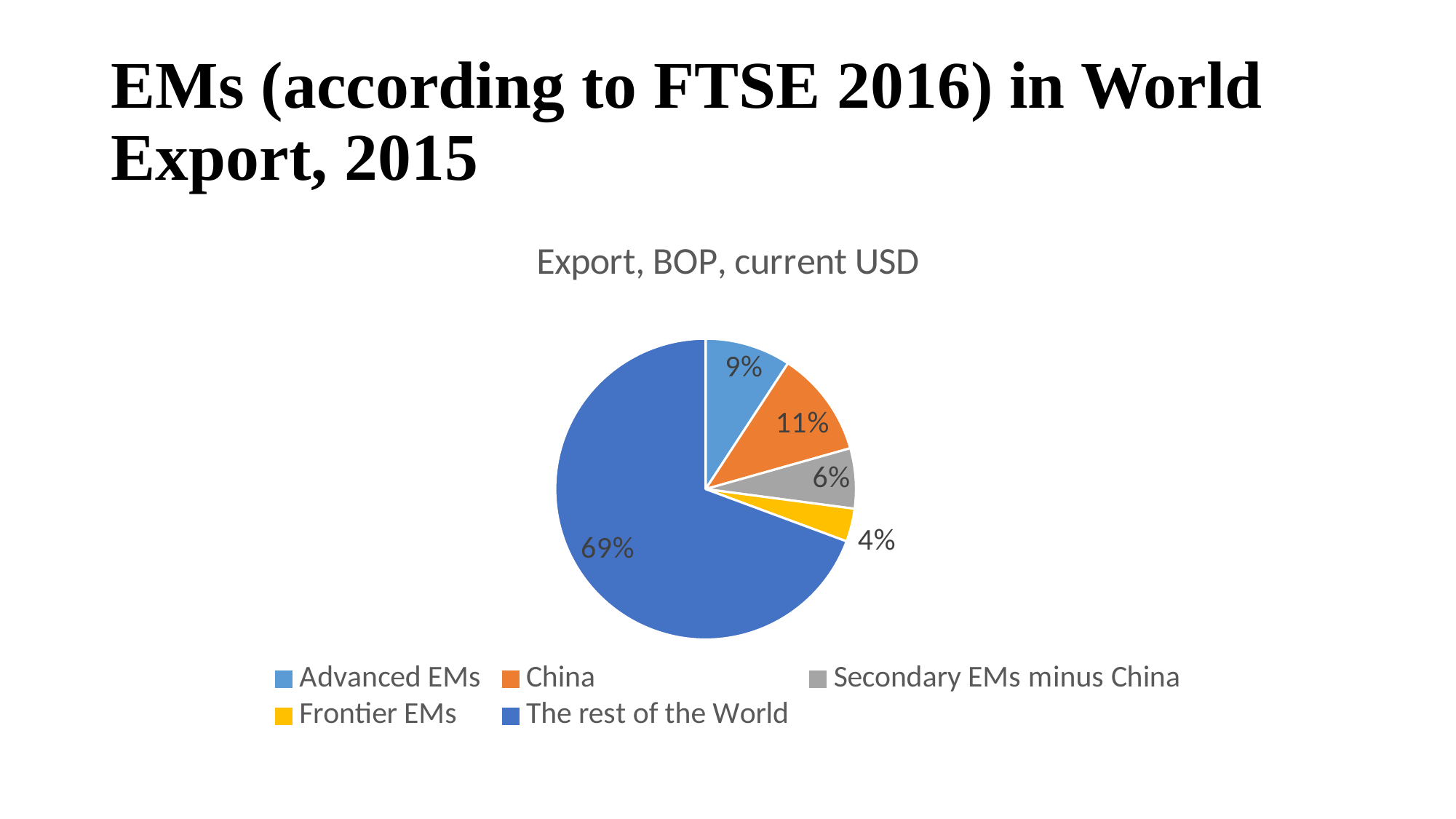
What share of world export does The rest of the World account for? 69% Which category has the smallest slice of the pie? Frontier EMs What kind of chart is shown on the slide? Pie chart What share of world export does Secondary EMs minus China account for? 6% What is the chart's title? Export, BOP, current USD How many categories does the legend list? 5 What share of world export do Frontier EMs account for? 4% What share of world export does China account for? 11% What is the difference in percentage points between the share for China and the share for Secondary EMs minus China? 5 What share of world export do Advanced EMs account for? 9% Which is larger, the share for China or the share for Advanced EMs? China Which category has the largest slice of the pie? The rest of the World